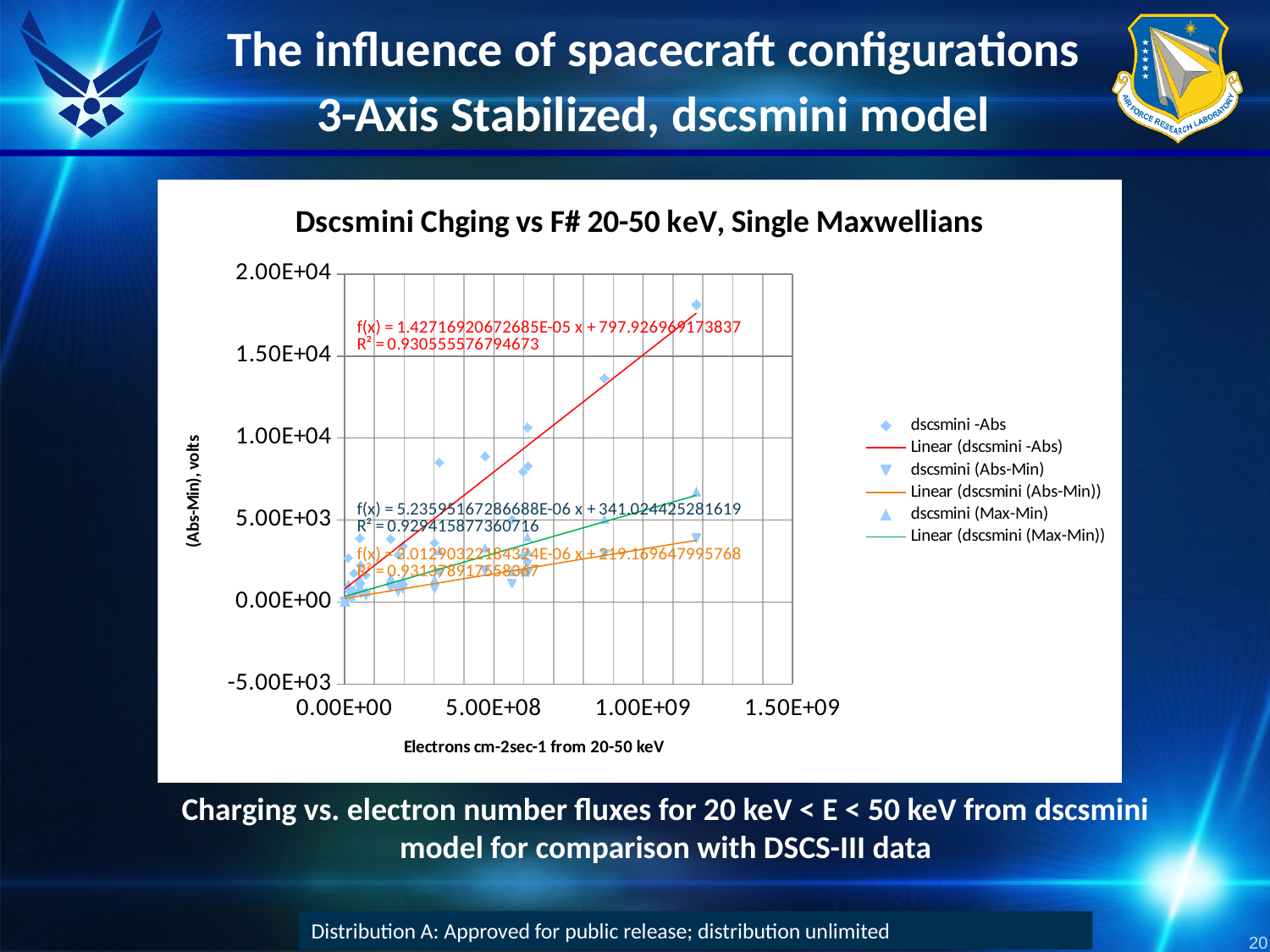
What is the R² value printed for the dscsmini (Max-Min) linear fit (the green trendline)? 0.929415877360716 At the largest electron flux plotted (around 1.2E+09), which is larger: the dscsmini -Abs value or the dscsmini (Abs-Min) value? dscsmini -Abs What is the intercept printed in the equation for the dscsmini (Max-Min) linear fit? 341.024425281619 What is the title of the chart? Dscsmini Chging vs F# 20-50 keV, Single Maxwellians What is the label of the y axis? (Abs-Min), volts Is the highest dscsmini -Abs data point greater or less than 1.50E+04 volts? greater What kind of chart is shown on the slide? Scatter chart Do the dscsmini -Abs values rise or fall as the electron flux on the x axis increases? Rise What is the slope printed in the equation for the dscsmini -Abs linear fit? 1.42716920672685E-05 What is the R² value printed for the dscsmini -Abs linear fit (the red trendline)? 0.930555576794673 Which series has the steepest linear trendline: dscsmini -Abs, dscsmini (Abs-Min), or dscsmini (Max-Min)? dscsmini -Abs How many entries does the chart legend list? 6